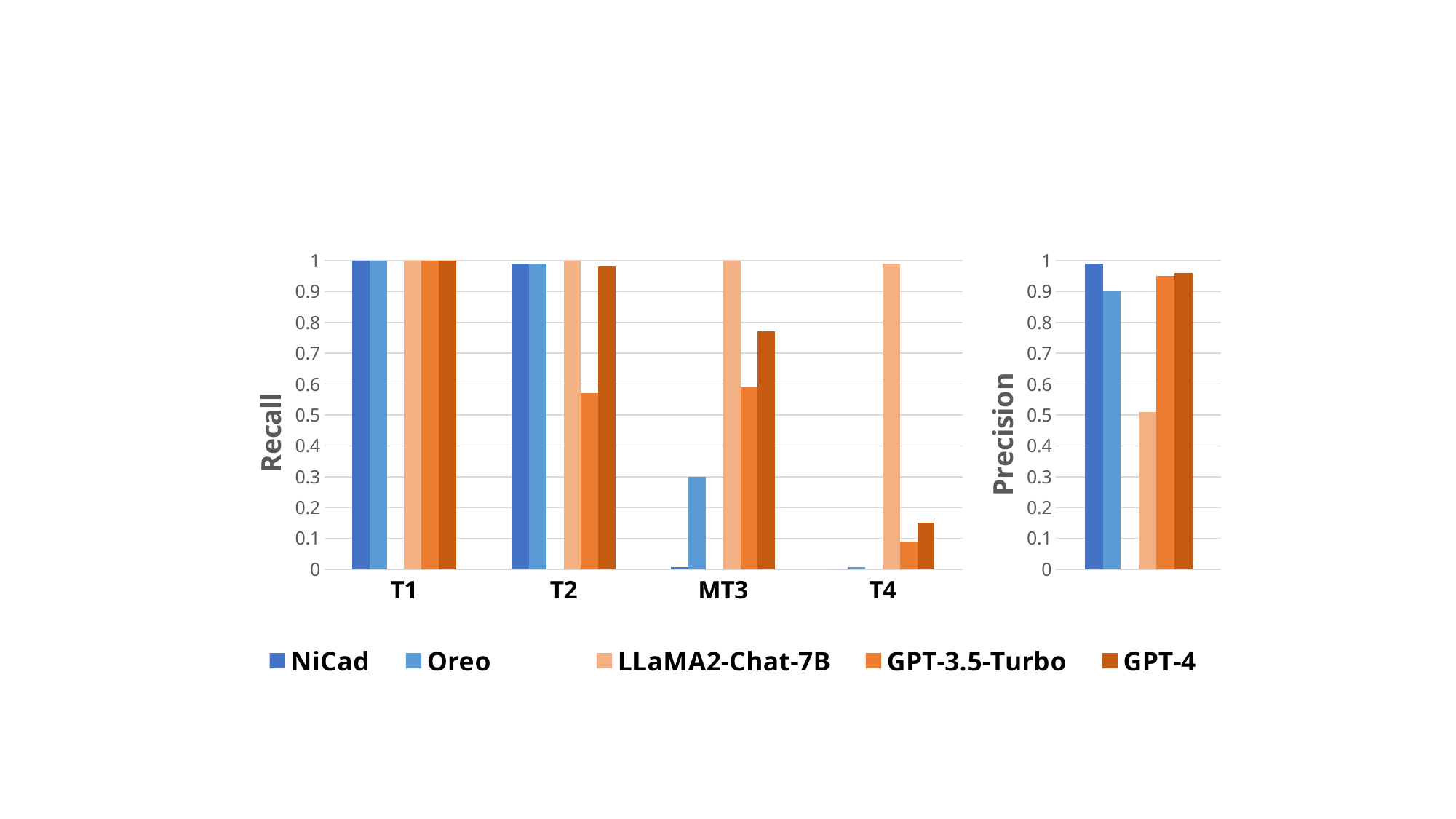
In the Recall chart, is the value for GPT-3.5-Turbo at T2 greater or less than 0.5? greater In the Recall chart, which series has the highest value at T4? LLaMA2-Chat-7B In the Recall chart at MT3, which is larger: Oreo or GPT-3.5-Turbo? GPT-3.5-Turbo In the Precision chart on the right, which series has the lowest value? LLaMA2-Chat-7B What kind of chart is the Recall chart on the left? bar chart In the Recall chart, is the value for GPT-4 at T4 greater or less than 0.2? less In the Recall chart, what is the value for LLaMA2-Chat-7B at T1? 1 How many categories are shown on the x axis of the Recall chart? 4 How many series does the legend list? 5 In the Recall chart, what is the value for Oreo at MT3? 0.3 In the Precision chart on the right, is the value for Oreo greater or less than 0.8? greater